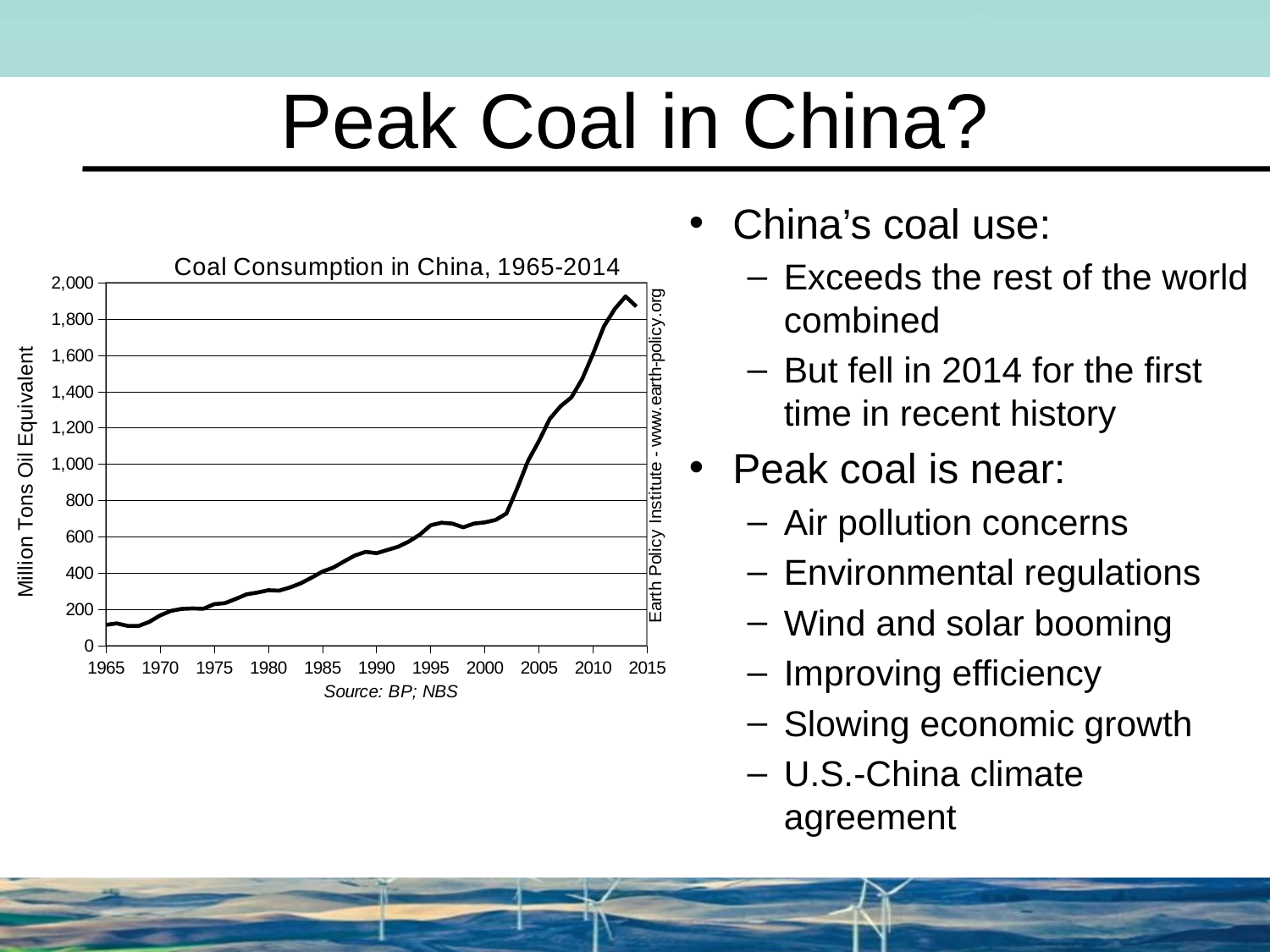
Is the coal consumption value for 2000 greater or less than 600? greater Is the coal consumption value for 1990 greater or less than 400? greater Is the coal consumption value for 2010 greater or less than 1,400? greater Is the coal consumption value for 2000 larger or smaller than the value for 1980? larger What is the label on the vertical axis of the chart? Million Tons Oil Equivalent Does coal consumption in China generally rise or fall from 1965 to 2014 on the chart? rise What is the title of the chart? Coal Consumption in China, 1965-2014 What kind of chart is shown on the slide? line chart